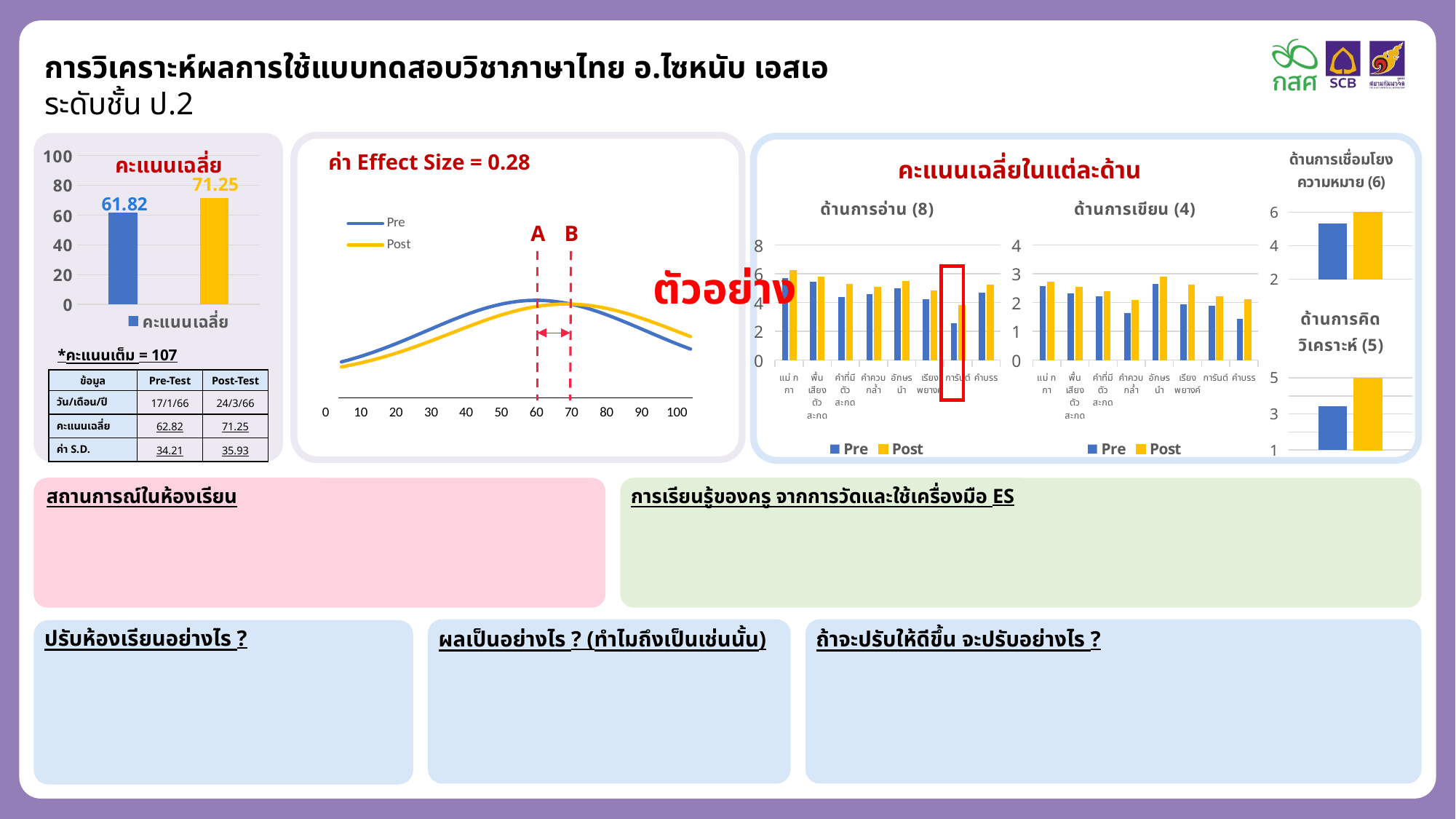
What kind of chart is the คะแนนเฉลี่ย chart on the left of the slide? bar chart In the ค่า Effect Size = 0.28 chart, what are the two legend entries? Pre and Post In the คะแนนเฉลี่ย bar chart, what is the difference between the yellow bar and the blue bar? 9.43 In the ด้านการอ่าน (8) chart, which category has the lowest Pre value? การันต์ What kind of chart is the ค่า Effect Size = 0.28 chart? line chart How many series does the legend of the ด้านการอ่าน (8) chart list? 2 How many categories are shown on the x axis of the ด้านการอ่าน (8) chart? 8 In the ด้านการอ่าน (8) chart, is the Pre value for การันต์ greater or less than 4? less In the คะแนนเฉลี่ย bar chart, what is the value of the blue bar? 61.82 In the คะแนนเฉลี่ย bar chart, which bar is taller, the blue one or the yellow one? the yellow one (71.25) How many categories are shown on the x axis of the ด้านการเขียน (4) chart? 8 In the คะแนนเฉลี่ย bar chart, what is the value of the yellow bar? 71.25